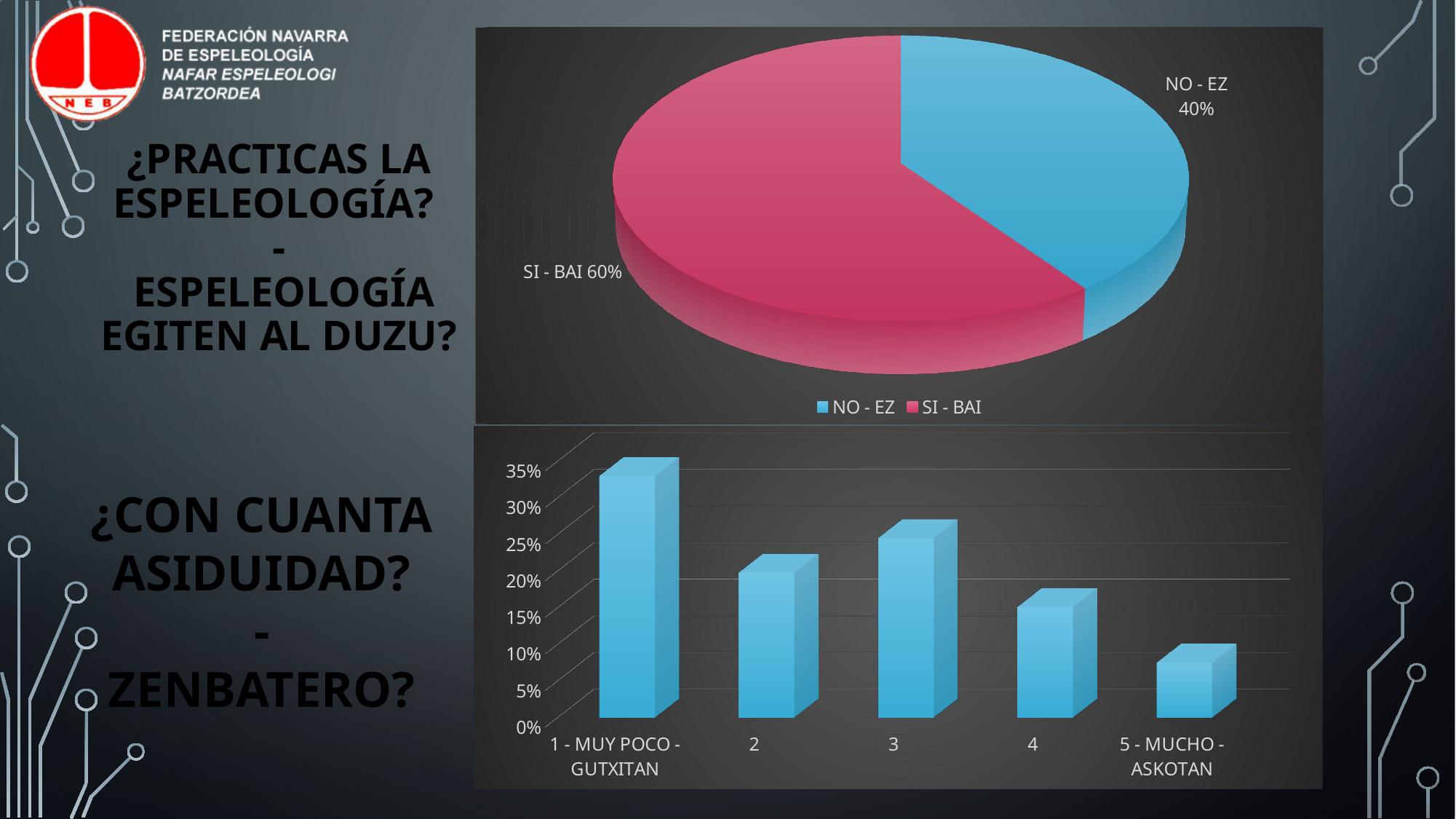
In the bottom bar chart, how many categories are shown on the x axis? 5 In the bottom bar chart, which category has the highest bar? 1 - MUY POCO - GUTXITAN In the top pie chart, what percentage is shown for NO - EZ? 40% In the bottom bar chart, which bar is taller, category 2 or category 3? 3 In the bottom bar chart, is the value for 1 - MUY POCO - GUTXITAN greater or less than 30%? greater How many entries does the legend of the top pie chart list? 2 What kind of chart is the top chart on the slide? Pie chart In the bottom bar chart, which category has the lowest bar? 5 - MUCHO - ASKOTAN What kind of chart is the bottom chart on the slide? Bar chart In the top pie chart, what percentage is shown for SI - BAI? 60% In the bottom bar chart, is the value for 5 - MUCHO - ASKOTAN greater or less than 10%? less In the top pie chart, which slice is larger, NO - EZ or SI - BAI? SI - BAI